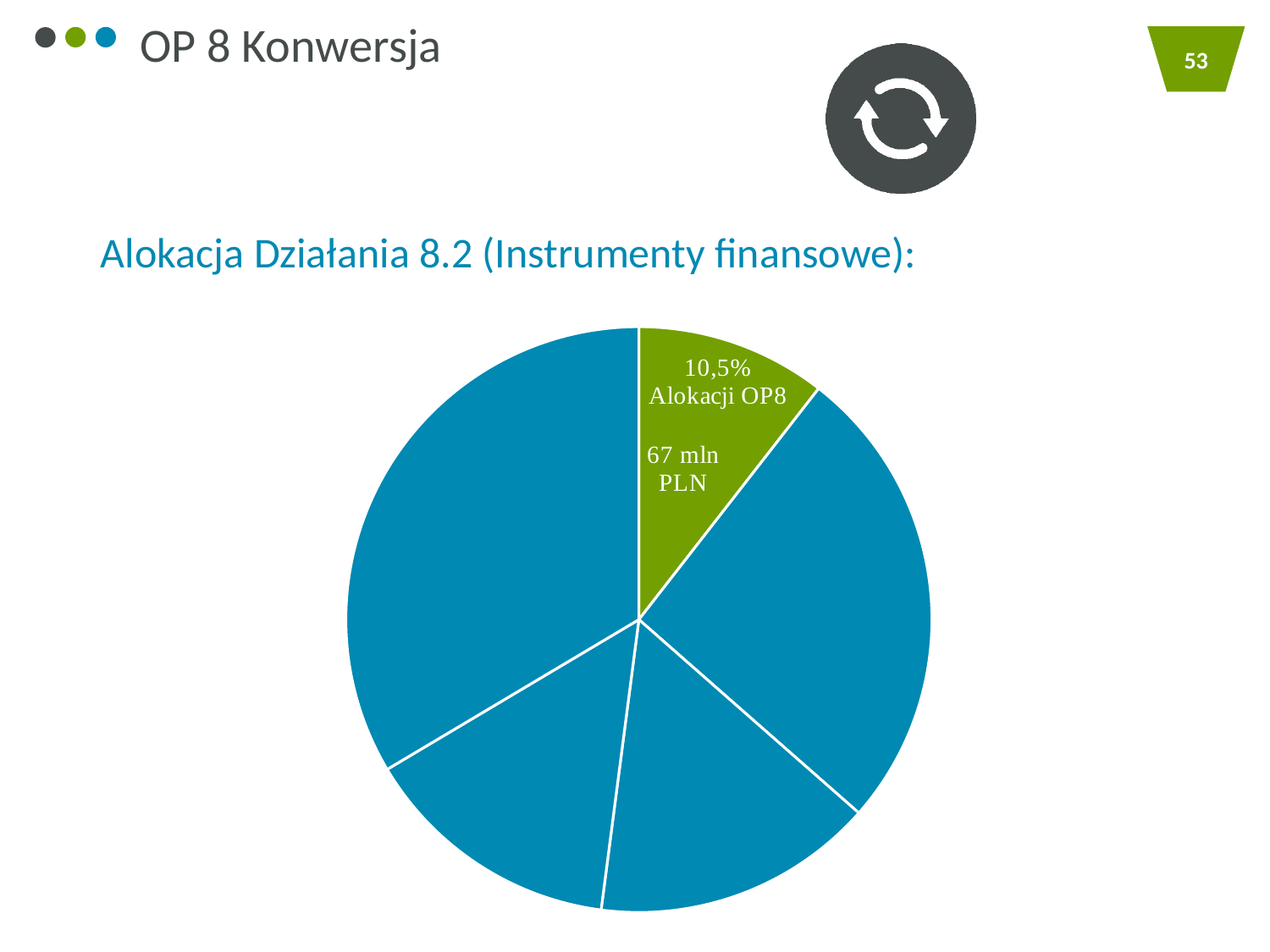
What kind of chart is shown on the slide? pie chart Is the green slice larger or smaller than the blue slice immediately clockwise from it? smaller What percentage share of the OP8 allocation does the green slice represent? 10,5% What colour is the slice labelled '10,5% Alokacji OP8'? green What is the heading printed above the pie chart? Alokacja Działania 8.2 (Instrumenty finansowe): Which slice of the pie chart is the smallest? the green slice (10,5% Alokacji OP8) What amount in PLN is printed on the green slice of the pie chart? 67 mln PLN How many slices of the pie chart carry a printed data label? 1 How many slices does the pie chart have? 5